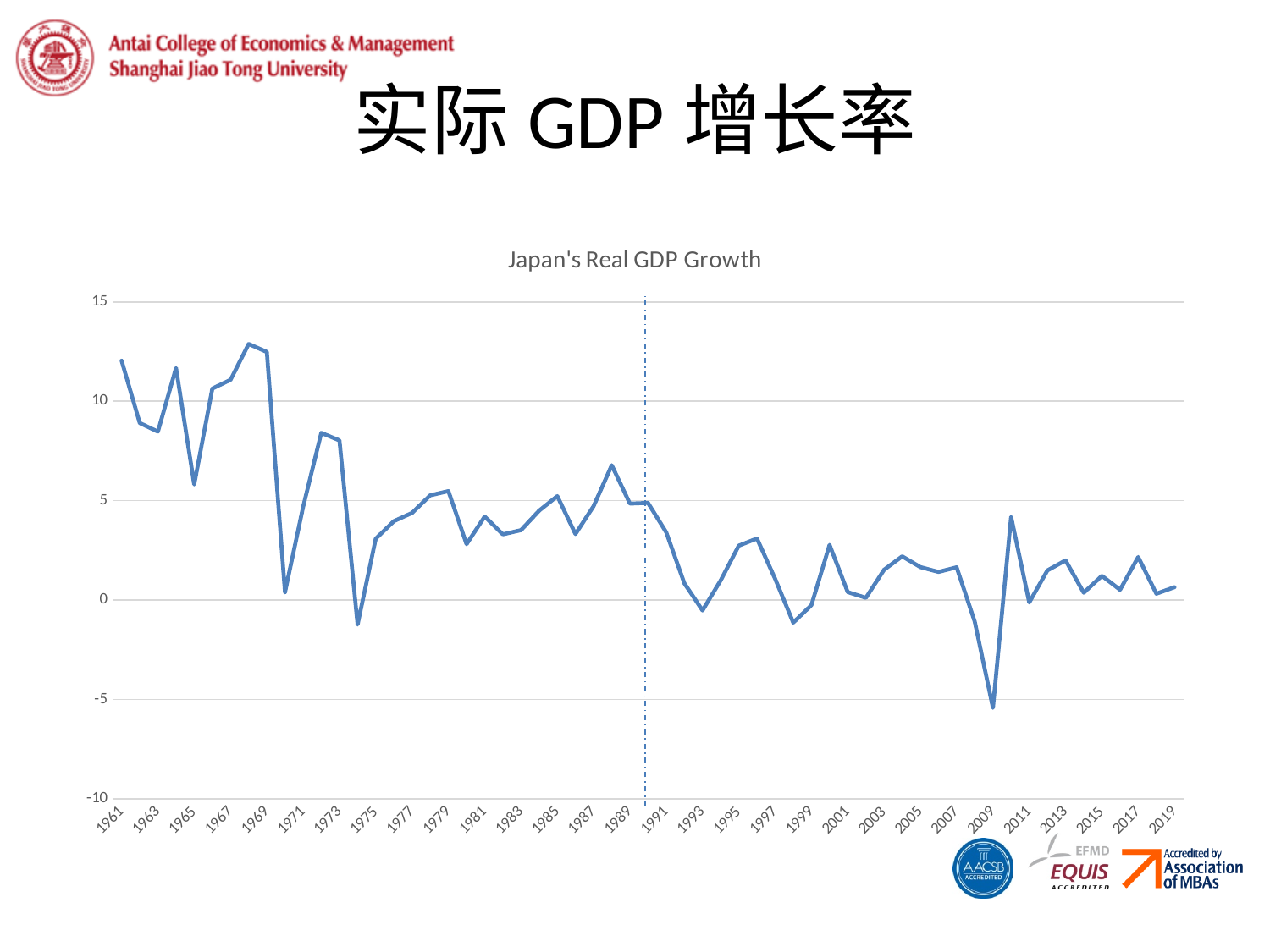
Is the value for 1961 greater or less than 10? greater Which year has the higher real GDP growth, 1974 or 2009? 1974 Overall, does Japan's real GDP growth rise or fall from 1961 to 2019? fall Is the value for 2009 greater or less than 0? less What is the title of the chart? Japan's Real GDP Growth Is the value for 1970 greater or less than 5? less In which year is Japan's real GDP growth lowest? 2009 What kind of chart is shown on the slide? line chart Around which year is the dashed vertical line drawn on the chart? 1990 Which year has the higher real GDP growth, 1961 or 2019? 1961